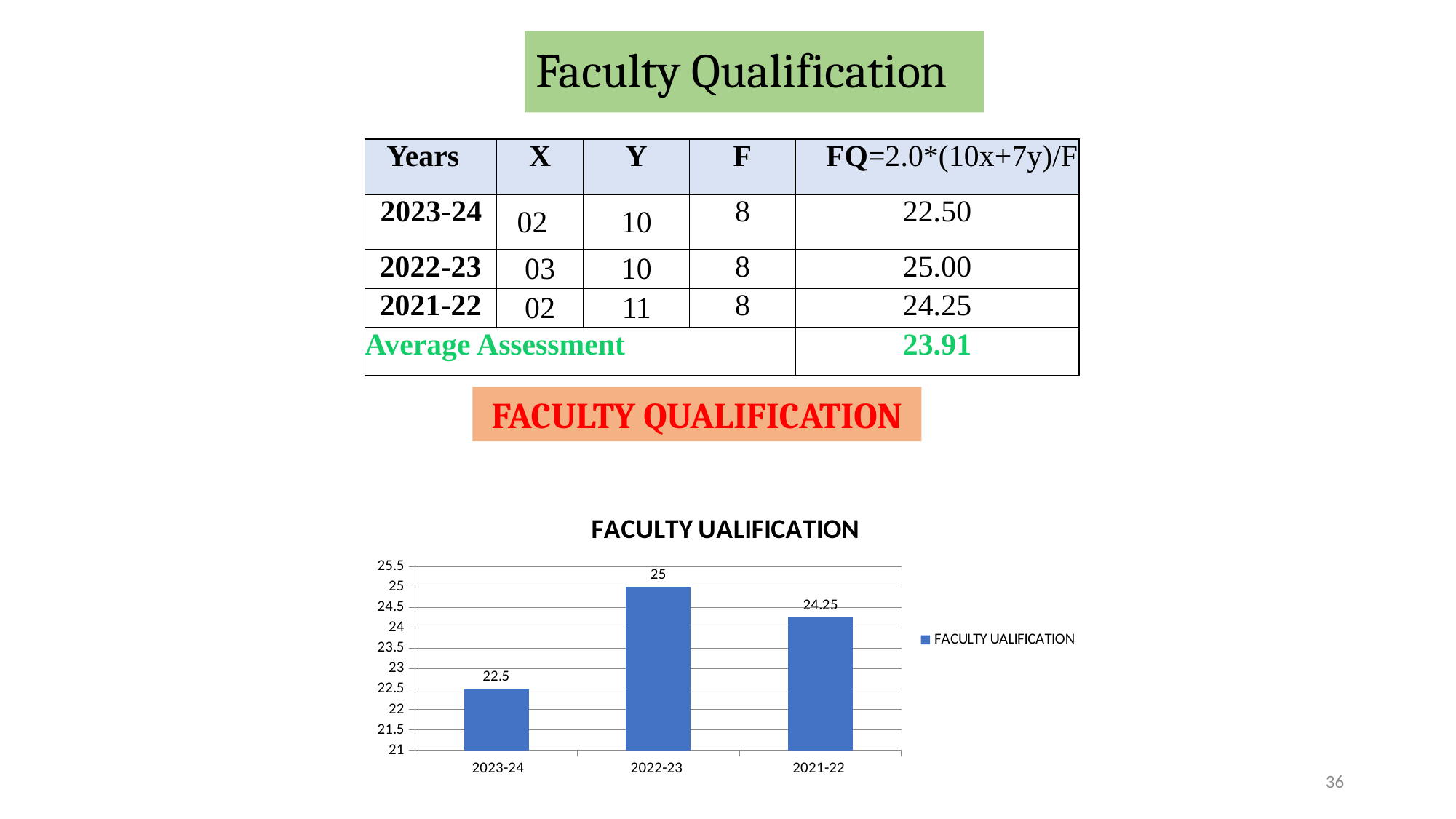
How many years are shown on the x axis of the chart? 3 What is the value for 2023-24 in the chart? 22.5 What is the value for 2022-23 in the chart? 25 Is the value for 2021-22 greater or less than 24? greater What is the title of the chart? FACULTY UALIFICATION What kind of chart is shown on the slide? bar chart What is the difference between the values for 2022-23 and 2021-22? 0.75 Which year has the highest value in the chart? 2022-23 What is the value for 2021-22 in the chart? 24.25 Which is larger, the value for 2021-22 or the value for 2023-24? 2021-22 What is the difference between the values for 2022-23 and 2023-24? 2.5 Which year has the lowest value in the chart? 2023-24